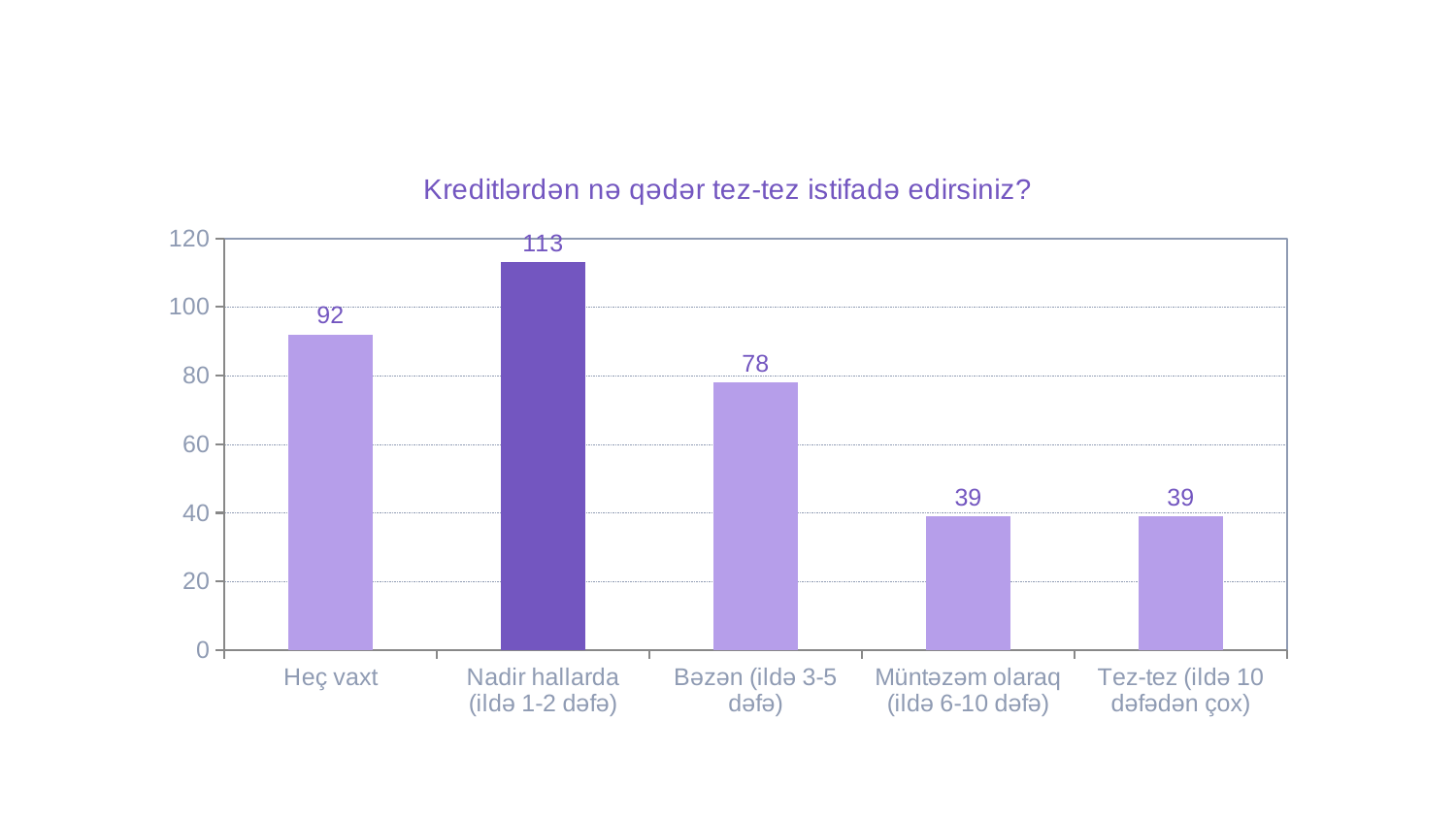
What is the title of the chart? Kreditlərdən nə qədər tez-tez istifadə edirsiniz? What is the difference between the values for "Nadir hallarda (ildə 1-2 dəfə)" and "Heç vaxt"? 21 Is the value for "Heç vaxt" greater or less than 100? less What is the value for "Nadir hallarda (ildə 1-2 dəfə)"? 113 How many categories are shown on the x axis? 5 Which category has the highest value? Nadir hallarda (ildə 1-2 dəfə) What is the difference between the values for "Bəzən (ildə 3-5 dəfə)" and "Tez-tez (ildə 10 dəfədən çox)"? 39 What kind of chart is shown on the slide? bar chart What is the value for "Müntəzəm olaraq (ildə 6-10 dəfə)"? 39 What is the value for "Heç vaxt"? 92 What is the value for "Bəzən (ildə 3-5 dəfə)"? 78 Which is larger, the value for "Heç vaxt" or the value for "Bəzən (ildə 3-5 dəfə)"? Heç vaxt